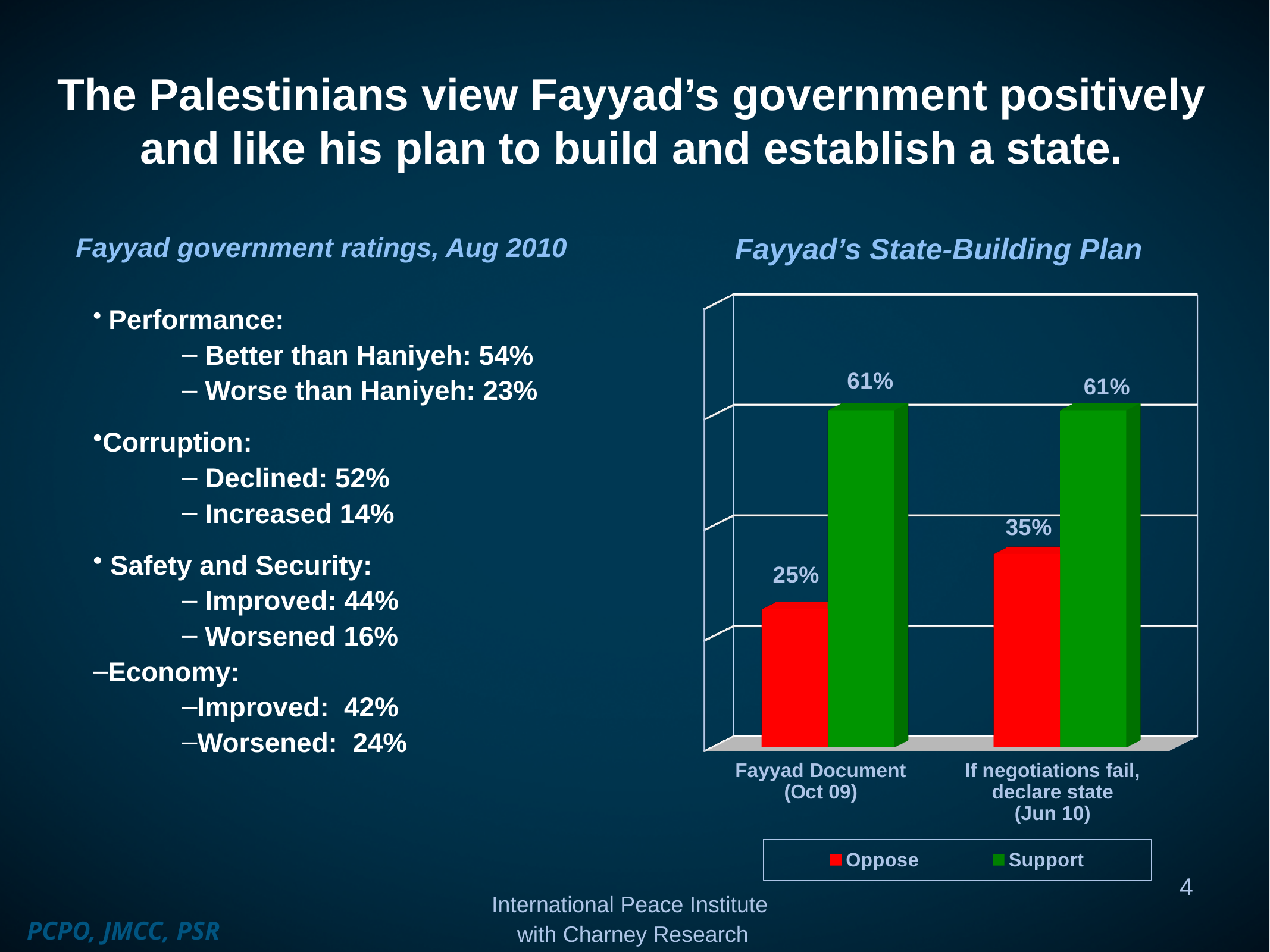
How many categories are shown on the x axis of the chart? 2 What is the Support value for Fayyad Document (Oct 09)? 61% What is the Oppose value for Fayyad Document (Oct 09)? 25% Which category has the higher Oppose value? If negotiations fail, declare state (Jun 10) What is the difference between the Oppose values for the two categories? 10% What is the Support value for If negotiations fail, declare state (Jun 10)? 61% What is the difference between the Support and Oppose values for Fayyad Document (Oct 09)? 36% What colour represents the Support series in the chart? green What is the Oppose value for If negotiations fail, declare state (Jun 10)? 35% Is the Oppose value for Fayyad Document (Oct 09) larger or smaller than the Support value for the same category? smaller What kind of chart is shown on the slide? bar chart How many series does the chart legend list? 2